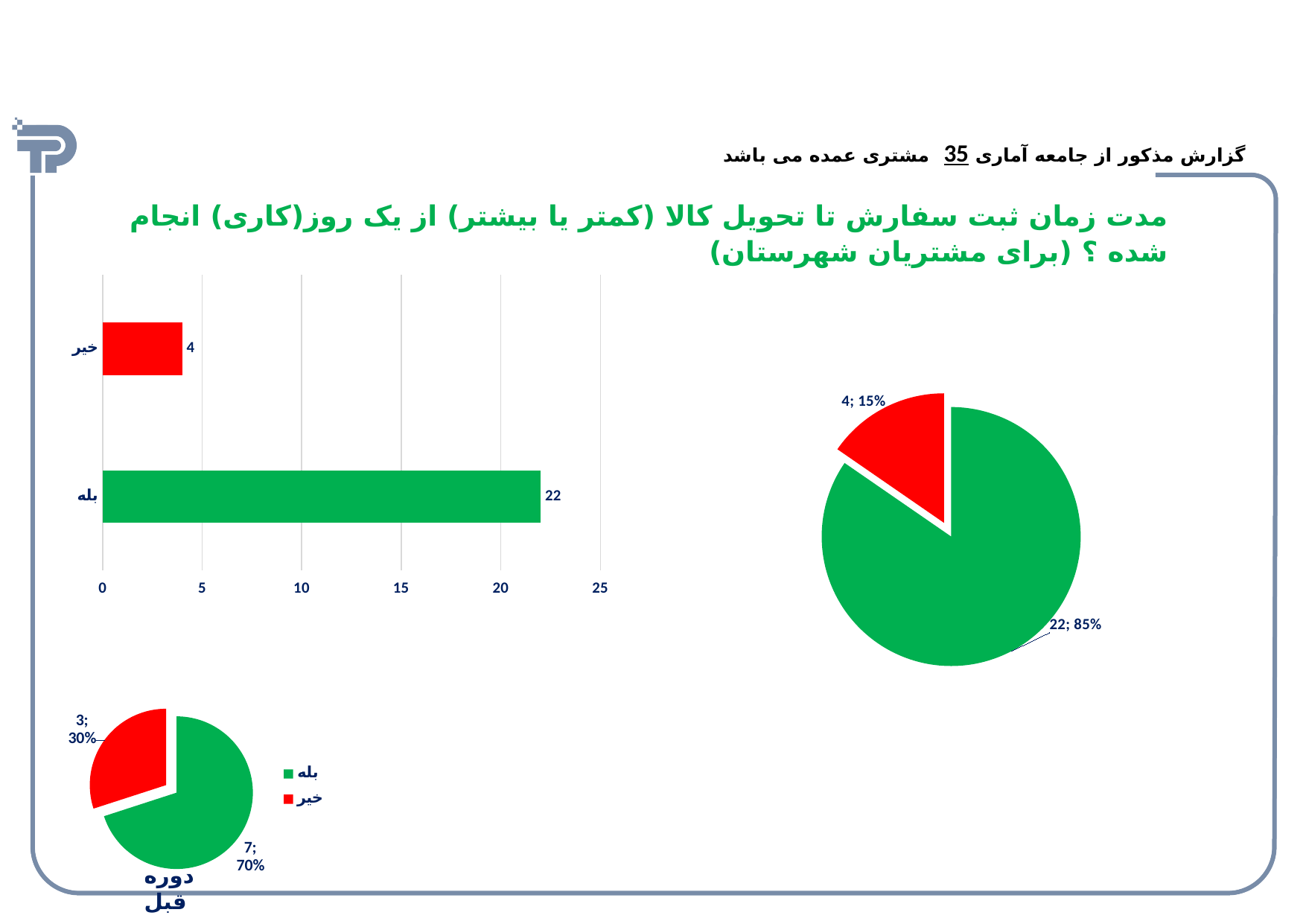
What kind of chart is shown at the top left of the slide? Bar chart In the bar chart at the top left, what is the value for خیر? 4 How many entries does the legend next to the bottom-left pie chart list? 2 In the bar chart at the top left, what is the difference between the values for بله and خیر? 18 In the small pie chart at the bottom left (دوره قبل), what value is shown for the green slice (بله)? 7 In the bar chart at the top left, how many categories are shown? 2 In the bar chart at the top left, what is the value for بله? 22 In the small pie chart at the bottom left (دوره قبل), which slice is larger, بله or خیر? بله In the large pie chart on the right, what share does the green slice (بله) represent? 85% In the large pie chart on the right, what value is shown for the red slice (خیر)? 4 In the bar chart at the top left, which category has the highest value? بله In the small pie chart at the bottom left (دوره قبل), what share does the red slice (خیر) represent? 30%